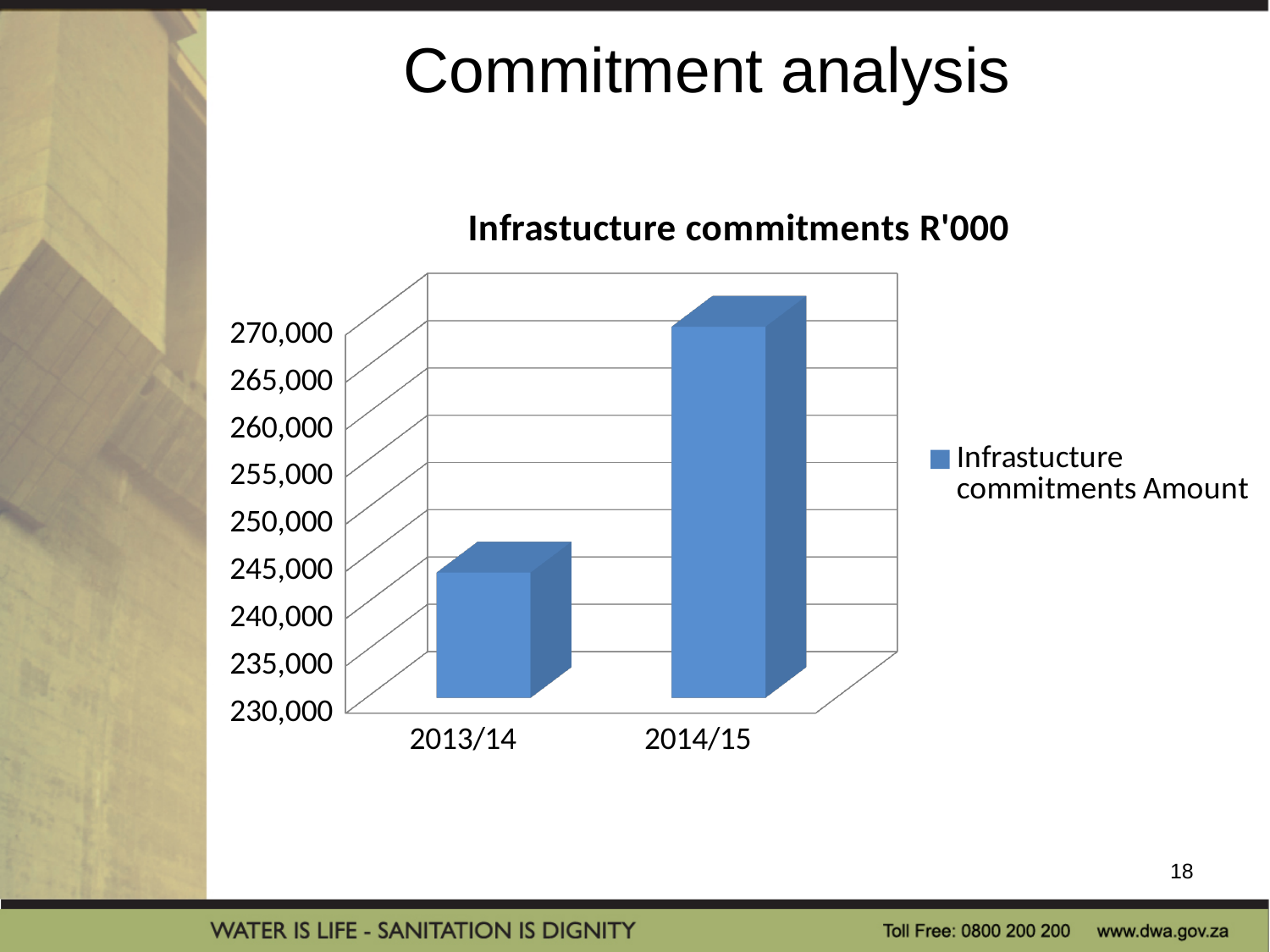
What kind of chart is shown on the slide? Bar chart What is the title of the chart? Infrastucture commitments R'000 What series name is shown in the chart's legend? Infrastucture commitments Amount How many series does the chart's legend list? 1 Is the value for 2014/15 greater or less than 260,000? greater Is the value for 2013/14 greater or less than 250,000? less Which year has the highest infrastructure commitments? 2014/15 How many categories are plotted on the x axis of the chart? 2 Which is larger, the value for 2013/14 or the value for 2014/15? 2014/15 Do the infrastructure commitments rise or fall from 2013/14 to 2014/15? Rise Which year has the lowest infrastructure commitments? 2013/14 Is the value for 2013/14 greater or less than 240,000? greater